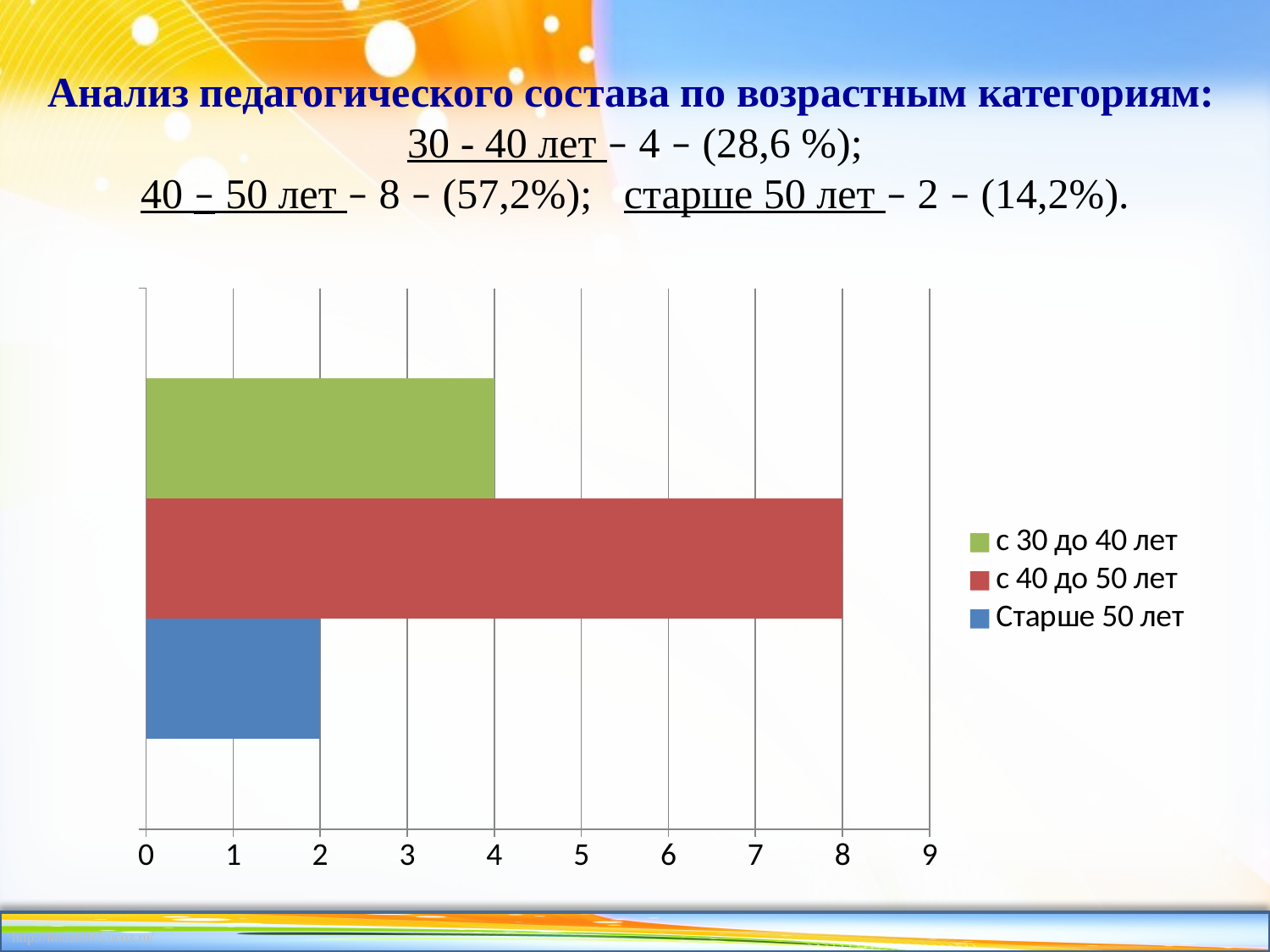
Which series has the lowest value? Старше 50 лет How many series does the legend list? 3 What is the value for the series "Старше 50 лет"? 2 Which series has the highest value? с 40 до 50 лет What kind of chart is shown on the slide? bar chart What is the value for the series "с 30 до 40 лет"? 4 What is the difference between the values for "с 40 до 50 лет" and "с 30 до 40 лет"? 4 Which is larger, the value for "с 30 до 40 лет" or the value for "Старше 50 лет"? с 30 до 40 лет What is the highest value shown on the horizontal axis? 9 What colour is the bar for "Старше 50 лет"? blue Is the value for "с 40 до 50 лет" greater or less than 5? greater What is the value for the series "с 40 до 50 лет"? 8